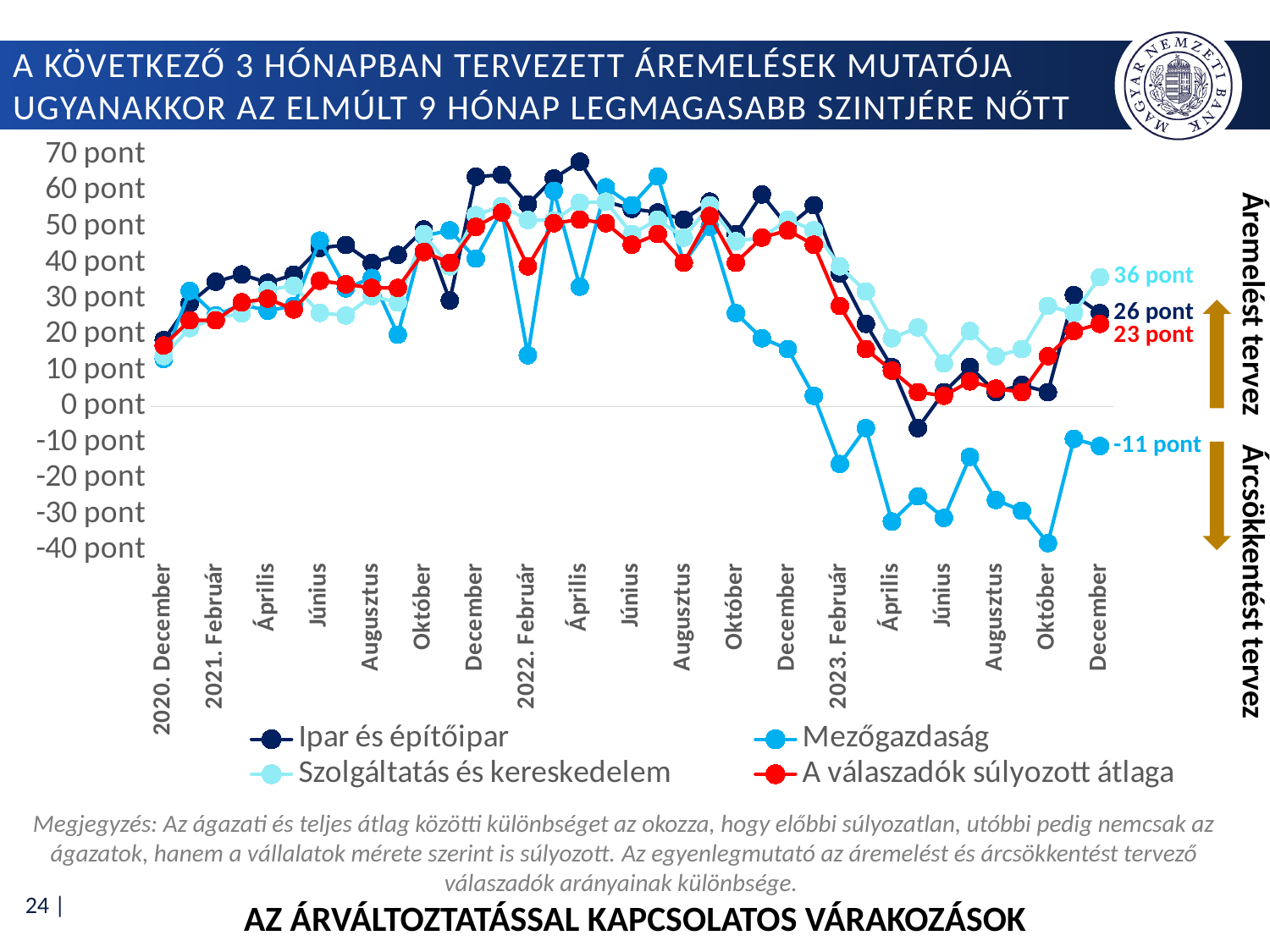
What kind of chart is shown on the slide? line chart What is the value for Szolgáltatás és kereskedelem at the last point (December 2023)? 36 pont Which series has the highest value at the last point (December 2023)? Szolgáltatás és kereskedelem Which is larger at December 2023: Ipar és építőipar or A válaszadók súlyozott átlaga? Ipar és építőipar Which series has the lowest value at the last point (December 2023)? Mezőgazdaság What is the value for Mezőgazdaság at the last point (December 2023)? -11 pont What is the difference between the December 2023 values of Szolgáltatás és kereskedelem and Ipar és építőipar? 10 pont How many series does the legend list? 4 Does the Mezőgazdaság series rise or fall between December 2022 and April 2023? fall What is the value for Ipar és építőipar at the last point (December 2023)? 26 pont Is the value for Mezőgazdaság in October 2023 greater or less than -30 pont? less What is the value for A válaszadók súlyozott átlaga at the last point (December 2023)? 23 pont